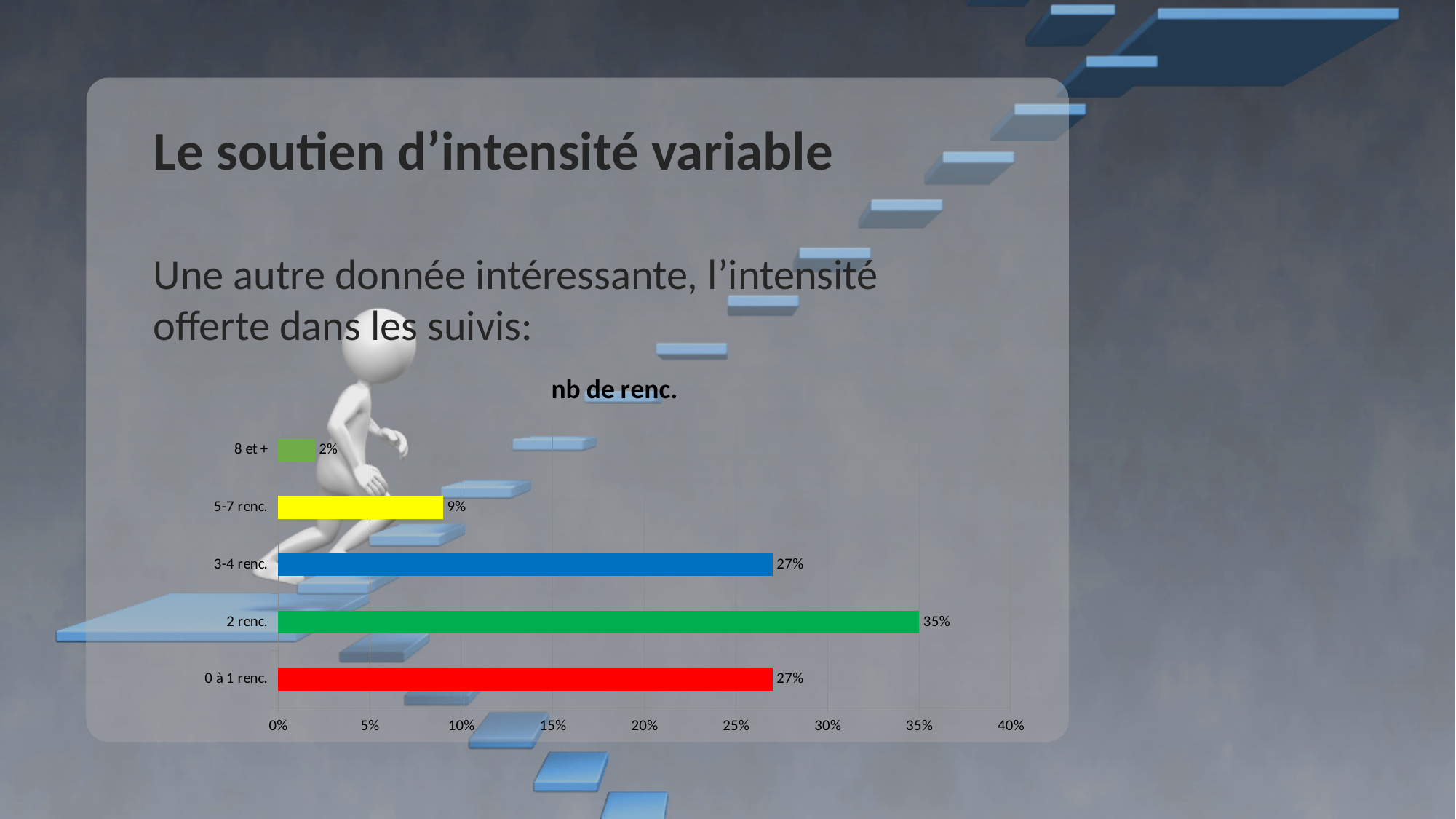
What is the value for "5-7 renc."? 9% What is the value for "8 et +"? 2% What is the title of the chart? nb de renc. What kind of chart is shown on the slide? bar chart Which category has the lowest value? 8 et + Is the value for "2 renc." greater or less than 30%? greater Which is larger, the value for "5-7 renc." or the value for "3-4 renc."? 3-4 renc. Which category has the highest value? 2 renc. What is the difference between the values for "2 renc." and "3-4 renc."? 8% What is the value for "2 renc."? 35% How many categories are shown in the chart? 5 What is the value for "0 à 1 renc."? 27%